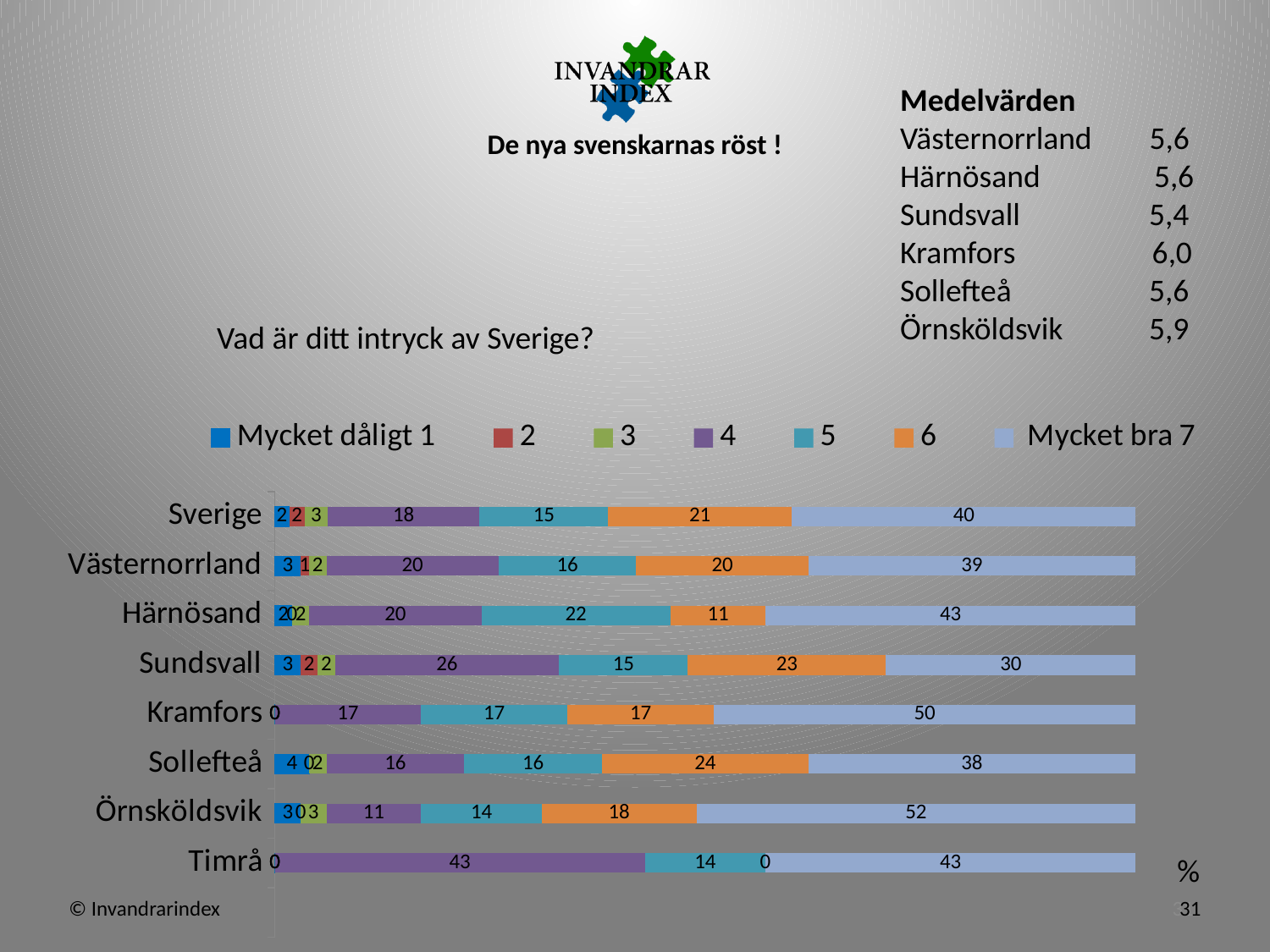
Which category has the highest value for the 'Mycket bra 7' series? Örnsköldsvik What is the value of series '4' for Timrå? 43 What is the value of the 'Mycket bra 7' series for Örnsköldsvik? 52 What is the value of series '6' for Sundsvall? 23 What is the value of series '5' for Härnösand? 22 Which category has the lowest value for the 'Mycket bra 7' series? Sundsvall How many categories are shown on the chart? 8 What is the first entry in the chart legend? Mycket dåligt 1 How many series does the legend list? 7 What is the difference between the 'Mycket bra 7' values for Sverige and Sundsvall? 10 What kind of chart is shown on the slide? Stacked bar chart Which has the larger 'Mycket bra 7' value, Kramfors or Västernorrland? Kramfors